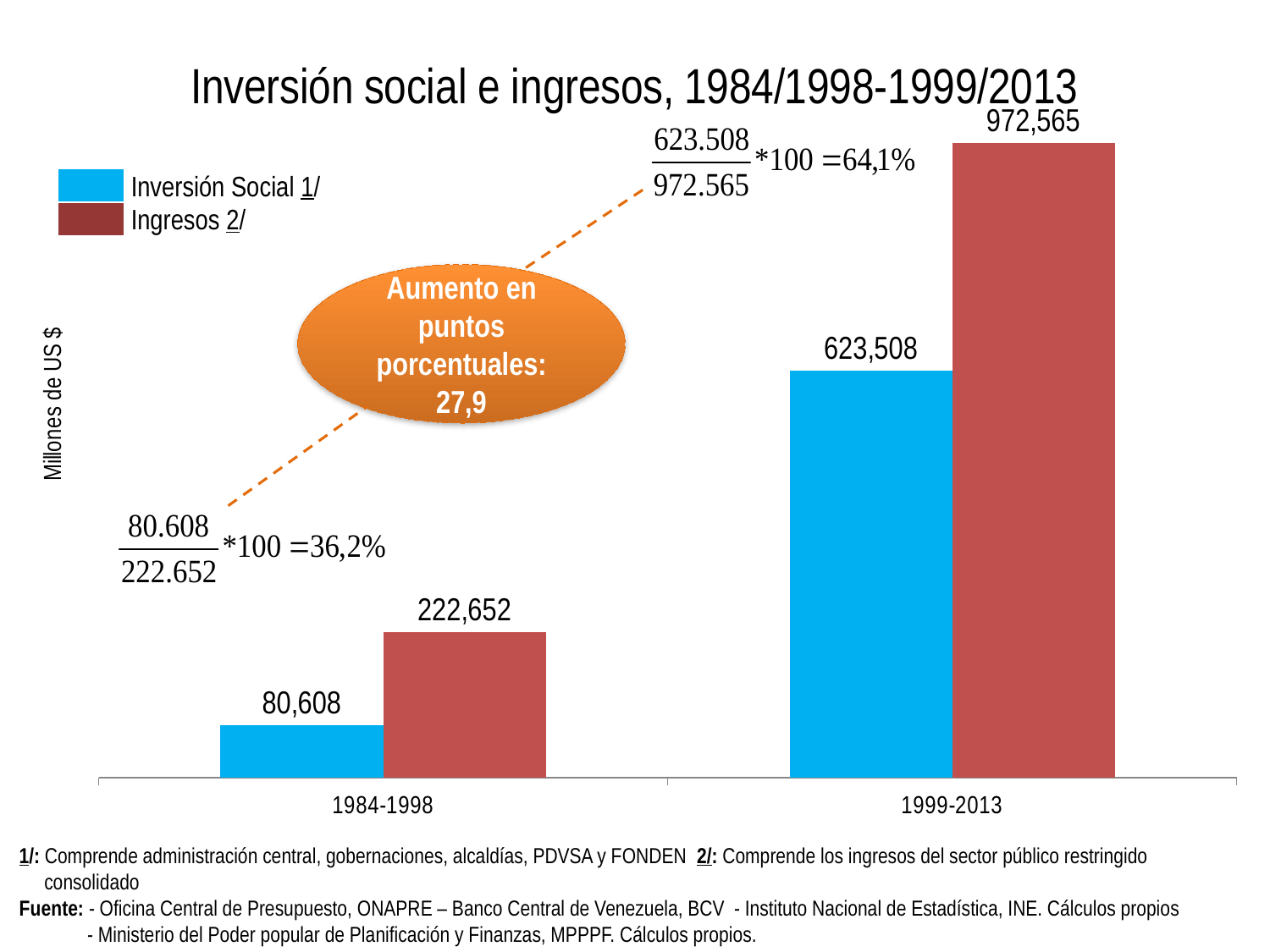
Which period has the highest Ingresos value? 1999-2013 What is the value of Ingresos for 1999-2013? 972,565 How many periods are shown on the x axis? 2 Which period has the lowest Inversión Social value? 1984-1998 What kind of chart is shown on the slide? Bar chart What is the value of Ingresos for 1984-1998? 222,652 What is the difference between Ingresos in 1984-1998 and Ingresos in 1999-2013? 749,913 What is the value of Inversión Social for 1999-2013? 623,508 How many series does the legend list? 2 What is the difference between Ingresos and Inversión Social in 1999-2013? 349,057 Which is larger in 1984-1998, Inversión Social or Ingresos? Ingresos What is the value of Inversión Social for 1984-1998? 80,608